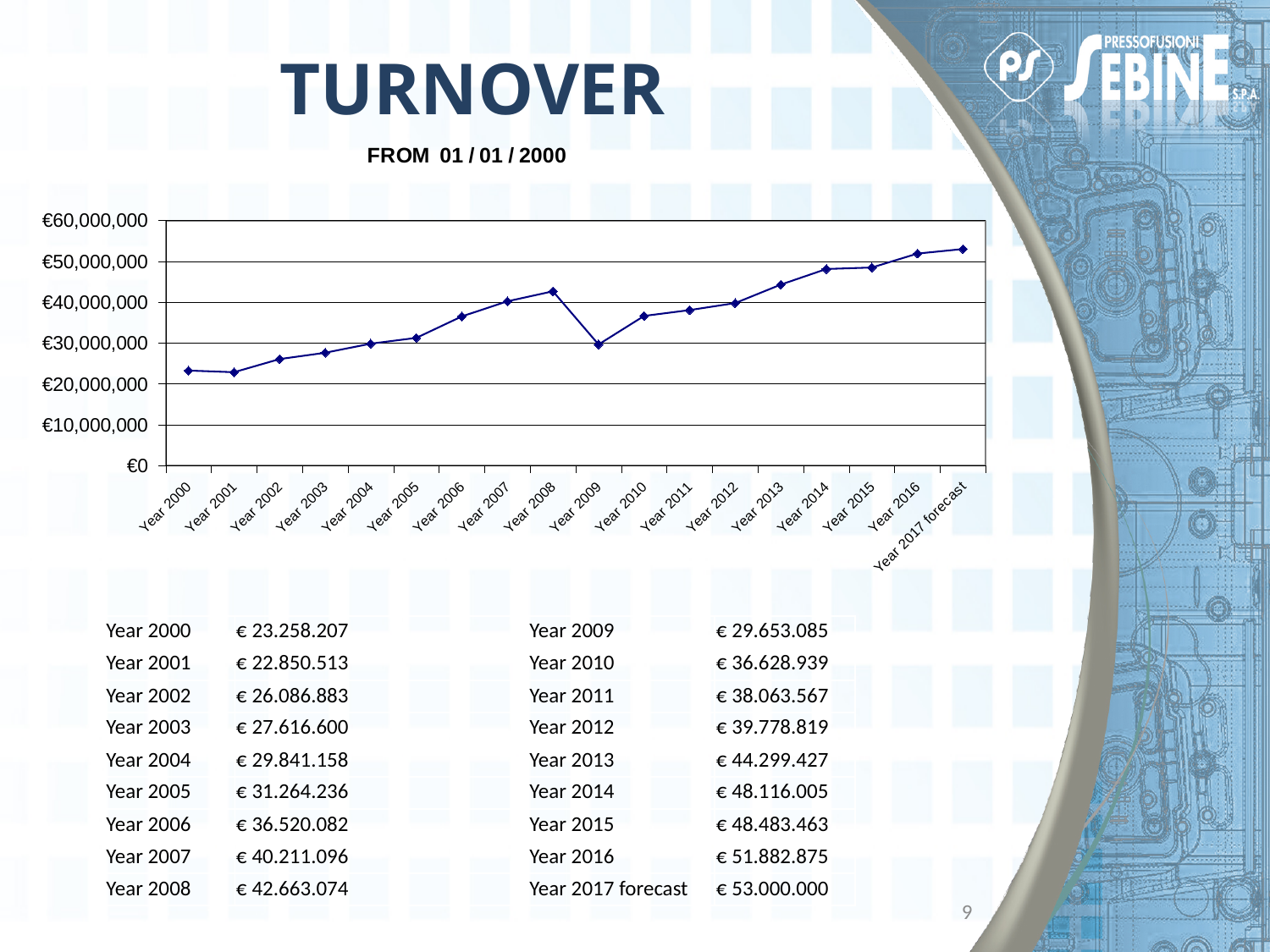
Does the turnover generally rise or fall from Year 2000 to Year 2017 forecast? rise Which year had the larger turnover, Year 2008 or Year 2010? Year 2008 Which year has the highest turnover on the chart? Year 2017 forecast How many years (data points) are plotted on the chart? 18 What was the turnover in Year 2008? € 42.663.074 What was the turnover in Year 2003? € 27.616.600 What is the difference in turnover between Year 2016 and Year 2015? € 3.399.412 Which year has the lowest turnover on the chart? Year 2001 What was the turnover in Year 2009? € 29.653.085 What is the difference in turnover between Year 2008 and Year 2009? € 13.009.989 What is the turnover value for Year 2017 forecast? € 53.000.000 What type of chart is shown on the slide? line chart